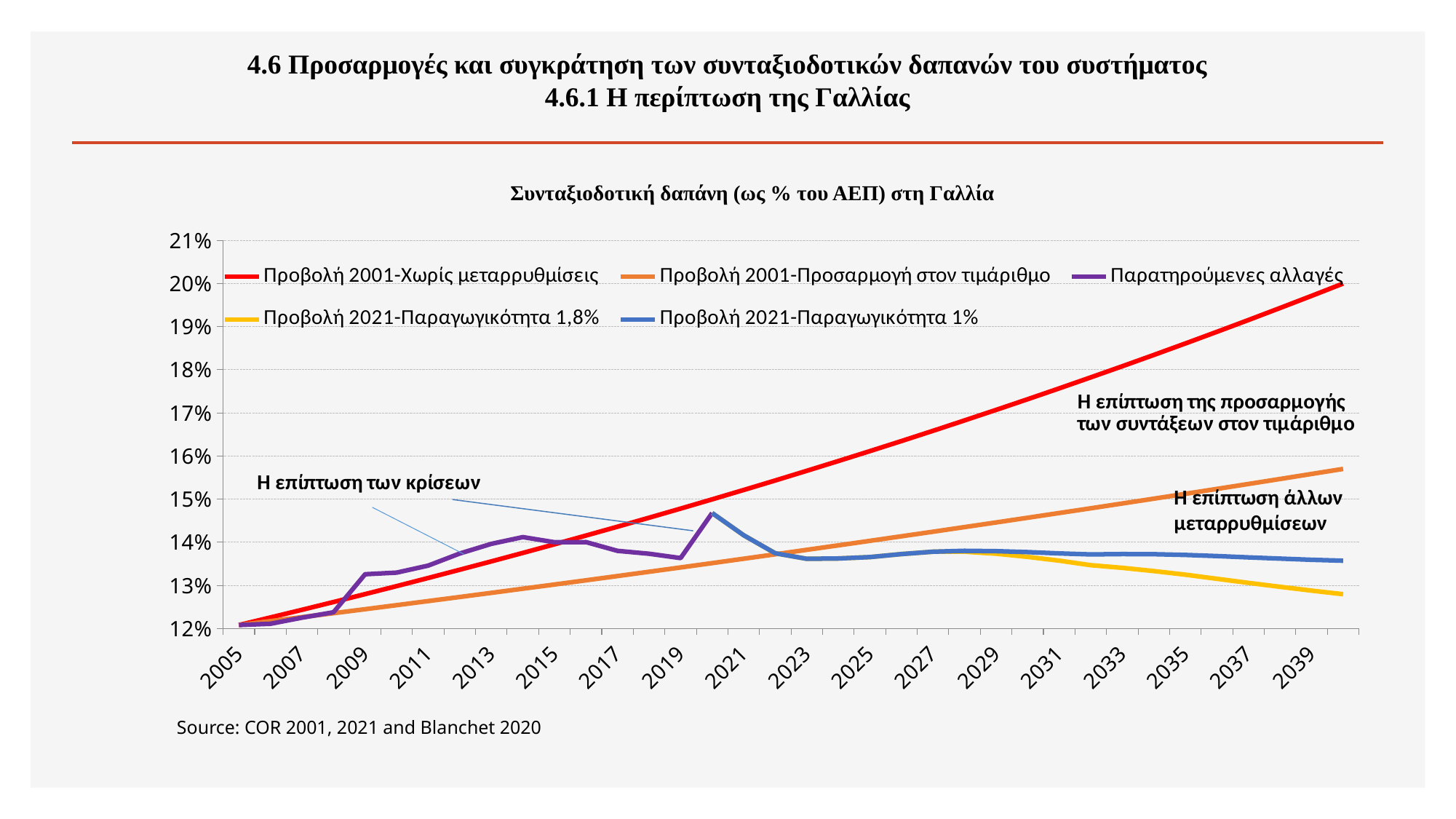
Does the 'Προβολή 2001-Χωρίς μεταρρυθμίσεις' series rise or fall from 2005 to 2039? rise At 2039, which is higher: 'Προβολή 2021-Παραγωγικότητα 1%' or 'Προβολή 2021-Παραγωγικότητα 1,8%'? Προβολή 2021-Παραγωγικότητα 1% What kind of chart is shown on the slide? line chart Is the value of 'Προβολή 2021-Παραγωγικότητα 1%' at the right end of the chart (2039-2040) greater or less than 14%? less Is the value of 'Προβολή 2001-Χωρίς μεταρρυθμίσεις' at the right end of the chart (2039-2040) greater or less than 19%? greater Which series reaches the highest value at the right end of the chart? Προβολή 2001-Χωρίς μεταρρυθμίσεις Which colour is used for the series 'Προβολή 2001-Χωρίς μεταρρυθμίσεις'? red Is the peak value of 'Παρατηρούμενες αλλαγές' around 2020 greater or less than 15%? less What is the title of the chart? Συνταξιοδοτική δαπάνη (ως % του ΑΕΠ) στη Γαλλία How many series does the legend list? 5